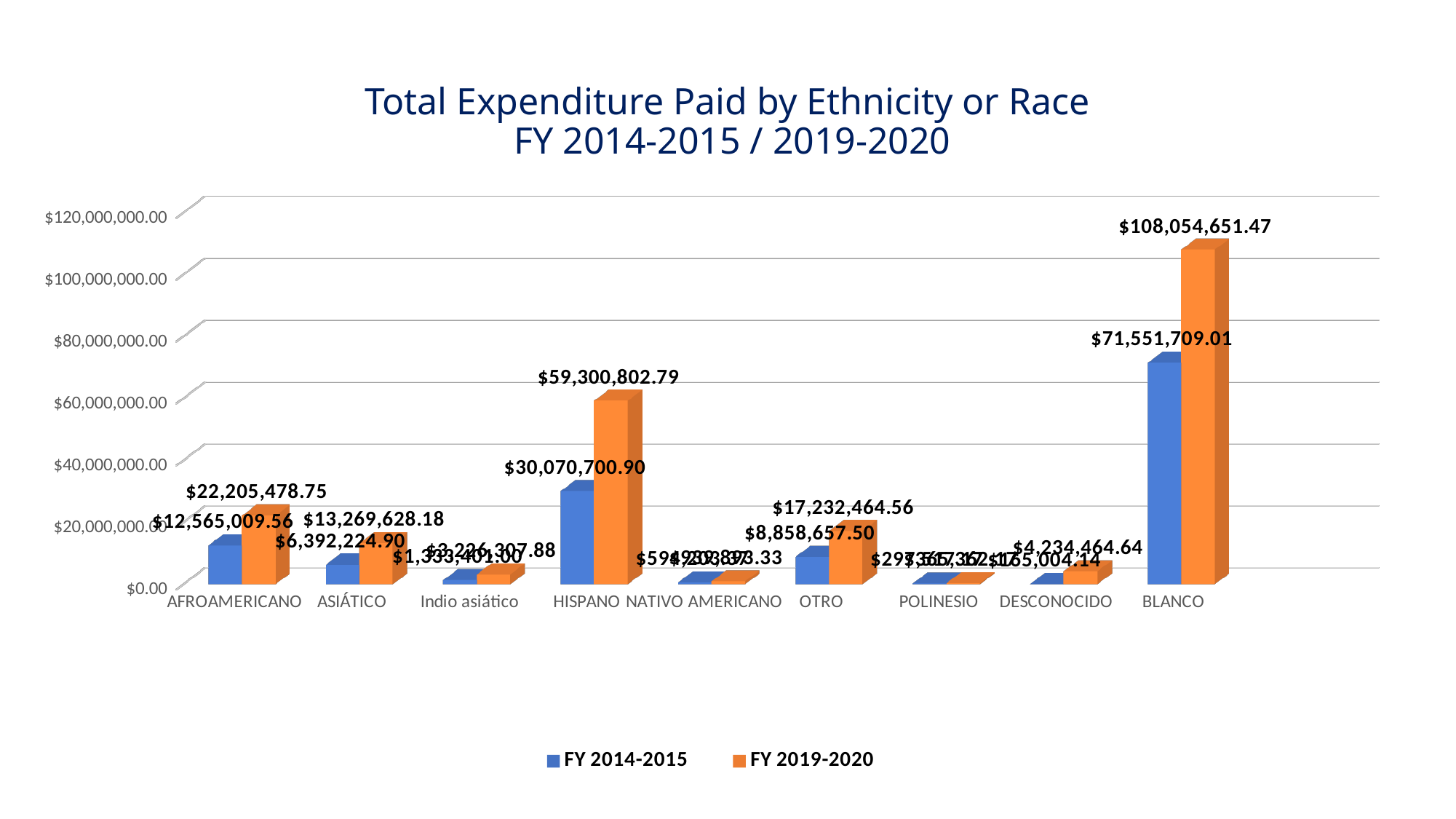
Which category has the highest FY 2019-2020 value? BLANCO What is the FY 2019-2020 value for BLANCO? $108,054,651.47 What type of chart is shown on the slide? Bar chart How many ethnicity or race categories are shown on the x axis? 9 What is the FY 2019-2020 value for AFROAMERICANO? $22,205,478.75 What is the title of the chart? Total Expenditure Paid by Ethnicity or Race FY 2014-2015 / 2019-2020 What is the FY 2014-2015 value for HISPANO? $30,070,700.90 What is the FY 2014-2015 value for OTRO? $8,858,657.50 What is the difference between the FY 2019-2020 and FY 2014-2015 values for BLANCO? $36,502,942.46 Which is larger for ASIÁTICO: the FY 2014-2015 value or the FY 2019-2020 value? FY 2019-2020 How many series does the legend list? 2 Is the FY 2014-2015 value for BLANCO greater or less than $60,000,000.00? greater